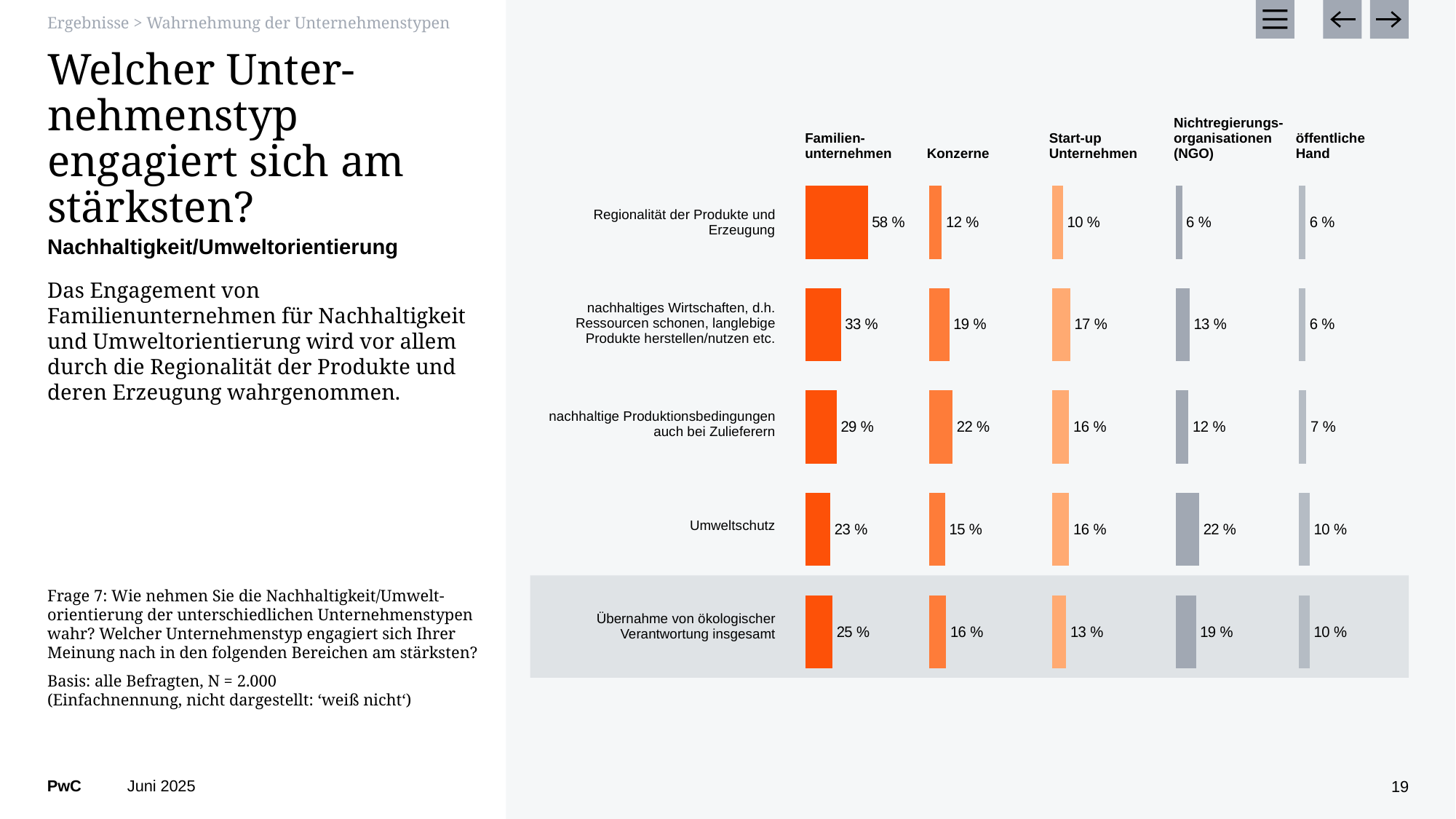
How many sustainability categories (rows) does the chart show? 5 How many company types are compared in the chart? 5 What percentage is shown for öffentliche Hand for 'Übernahme von ökologischer Verantwortung insgesamt'? 10 % Which row of the chart is highlighted with a grey background? Übernahme von ökologischer Verantwortung insgesamt Which company type has the lowest value for 'nachhaltige Produktionsbedingungen auch bei Zulieferern'? öffentliche Hand What kind of chart is shown on the slide? Bar chart What percentage is shown for Familienunternehmen for 'Regionalität der Produkte und Erzeugung'? 58 % For 'Umweltschutz', which is larger: the value for Familienunternehmen or the value for Konzerne? Familienunternehmen Which company type has the highest value for 'Regionalität der Produkte und Erzeugung'? Familienunternehmen What is the difference between the Familienunternehmen and Konzerne values for 'Regionalität der Produkte und Erzeugung'? 46 % What percentage is shown for Nichtregierungsorganisationen (NGO) for 'Umweltschutz'? 22 % What percentage is shown for Start-up Unternehmen for 'nachhaltiges Wirtschaften'? 17 %